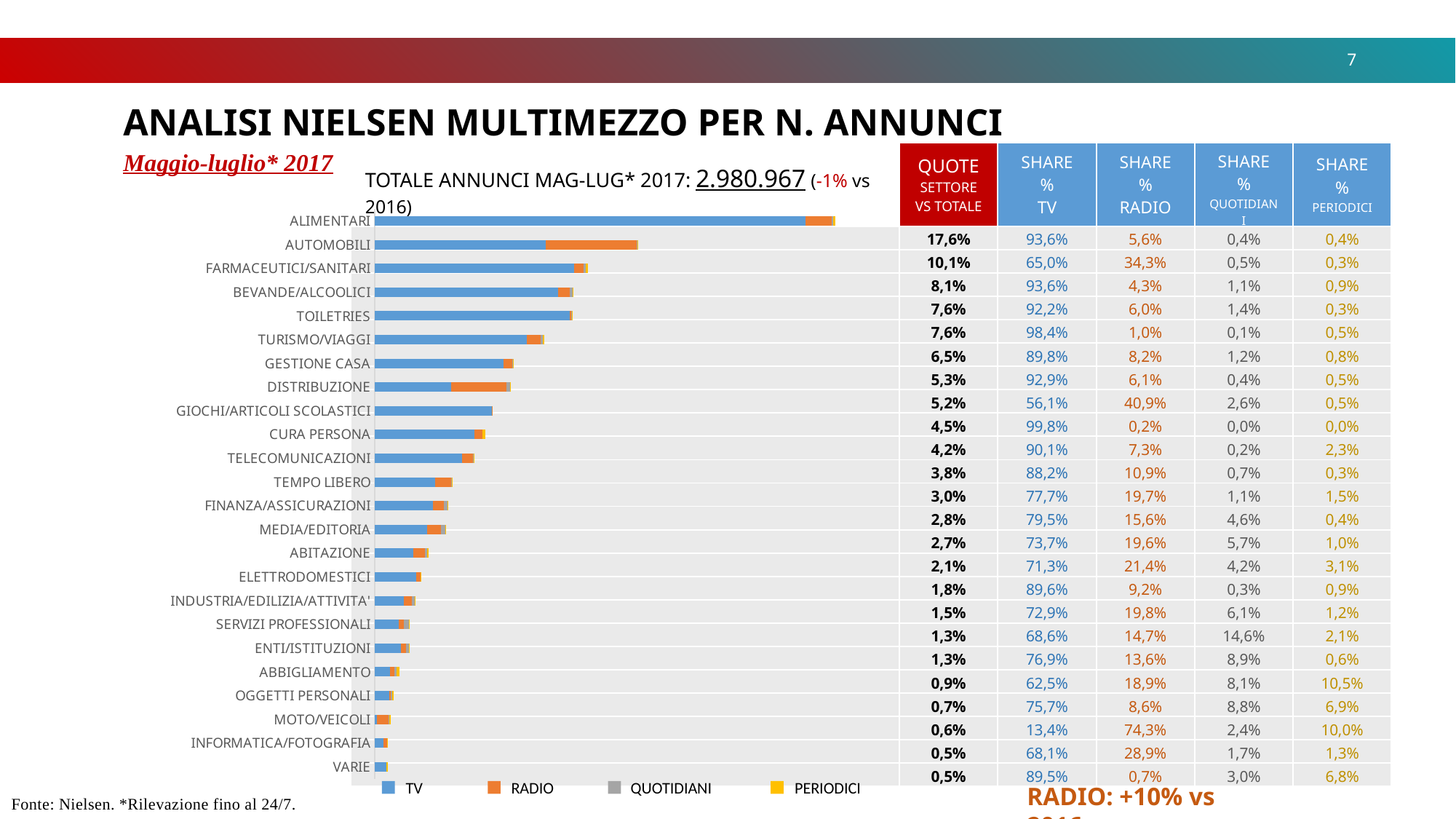
What is the QUOTE SETTORE VS TOTALE value for ALIMENTARI? 17,6% Which series is shown in blue in the chart legend? TV How many series does the chart legend list? 4 Which sector has the longer bar, AUTOMOBILI or FARMACEUTICI/SANITARI? AUTOMOBILI What is the total number of annunci for MAG-LUG* 2017 stated above the chart? 2.980.967 Do the bar lengths increase or decrease going from the top of the chart to the bottom? Decrease What is the SHARE % TV value for AUTOMOBILI? 65,0% Which sector has the longest bar in the chart? ALIMENTARI What kind of chart is shown on the slide? Stacked bar chart What is the difference between the QUOTE SETTORE VS TOTALE of ALIMENTARI (17,6%) and AUTOMOBILI (10,1%)? 7,5% How many categories (sectors) are listed on the chart's vertical axis? 24 What is the SHARE % RADIO value for MOTO/VEICOLI? 74,3%